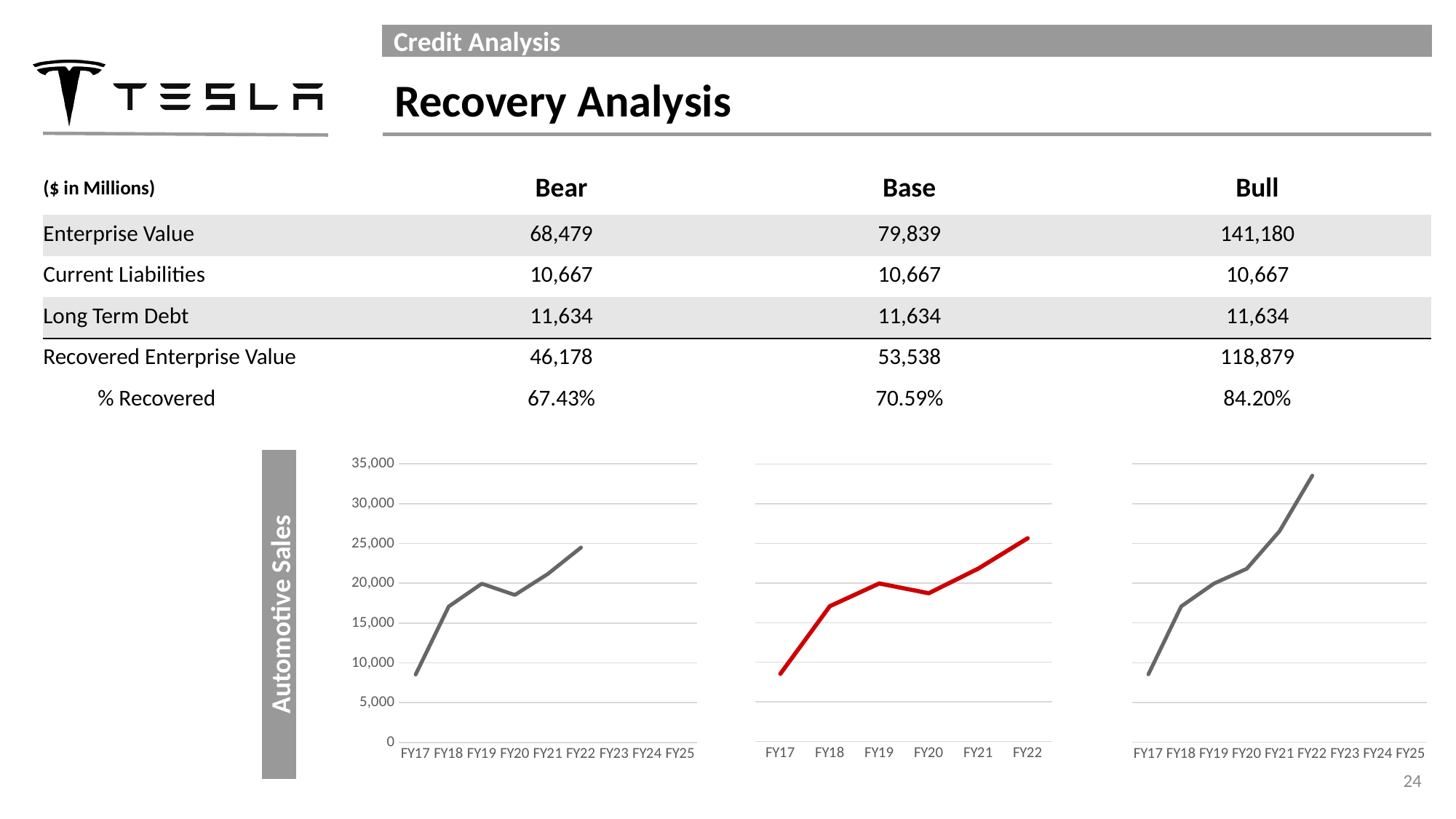
In the left chart, does the value rise or fall from FY19 to FY20? fall In the left chart, is the value for FY18 greater or less than 15,000? greater In the right chart, is the value for FY22 greater or less than 30,000? greater How many x-axis labels does the middle chart show? 6 In the left chart, which year has the highest value? FY22 In the left chart, is the value for FY20 greater or less than 20,000? less What colour is the line in the middle chart? red In the left chart, which is larger, the value for FY19 or the value for FY20? FY19 What kind of chart is the left chart under the Automotive Sales label? line chart In the right chart, do the values generally rise or fall from FY17 to FY22? rise